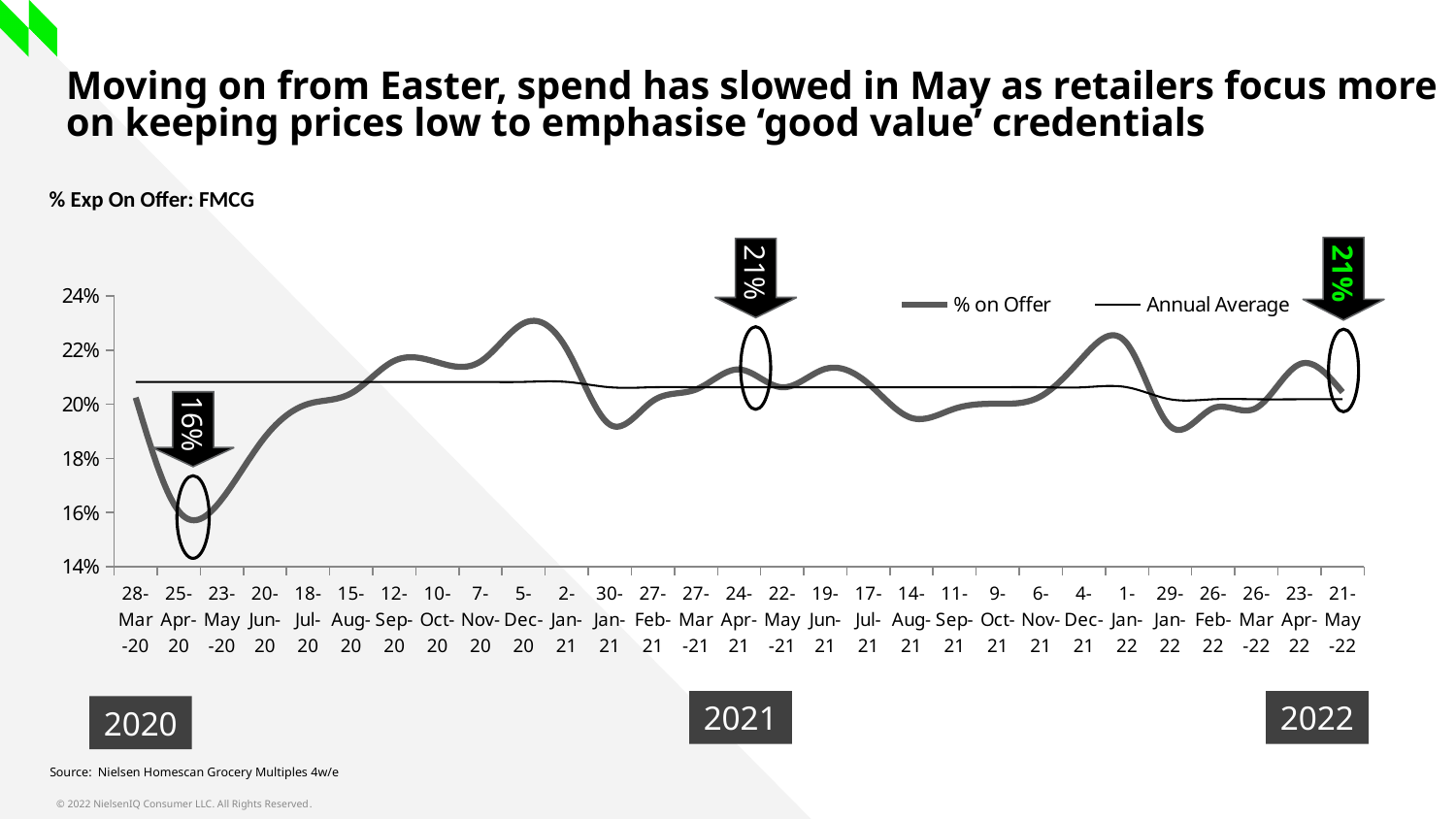
What are the two series named in the legend? % on Offer and Annual Average How many series does the chart legend list? 2 What value is called out for % on Offer at 21-May-22? 21% Is the % on Offer value at 25-Apr-20 greater or less than 18%? less Does the % on Offer line rise or fall between 25-Apr-20 and 5-Dec-20? rise Is the % on Offer value at 14-Aug-21 greater or less than 20%? less At which date does the % on Offer line reach its lowest point? 25-Apr-20 What is the lowest value called out on the % on Offer line? 16% Is the % on Offer value at 5-Dec-20 greater or less than 22%? greater What kind of chart is shown on the slide? line chart Which is higher on the % on Offer line: 5-Dec-20 or 30-Jan-21? 5-Dec-20 What is the title of the chart? % Exp On Offer: FMCG